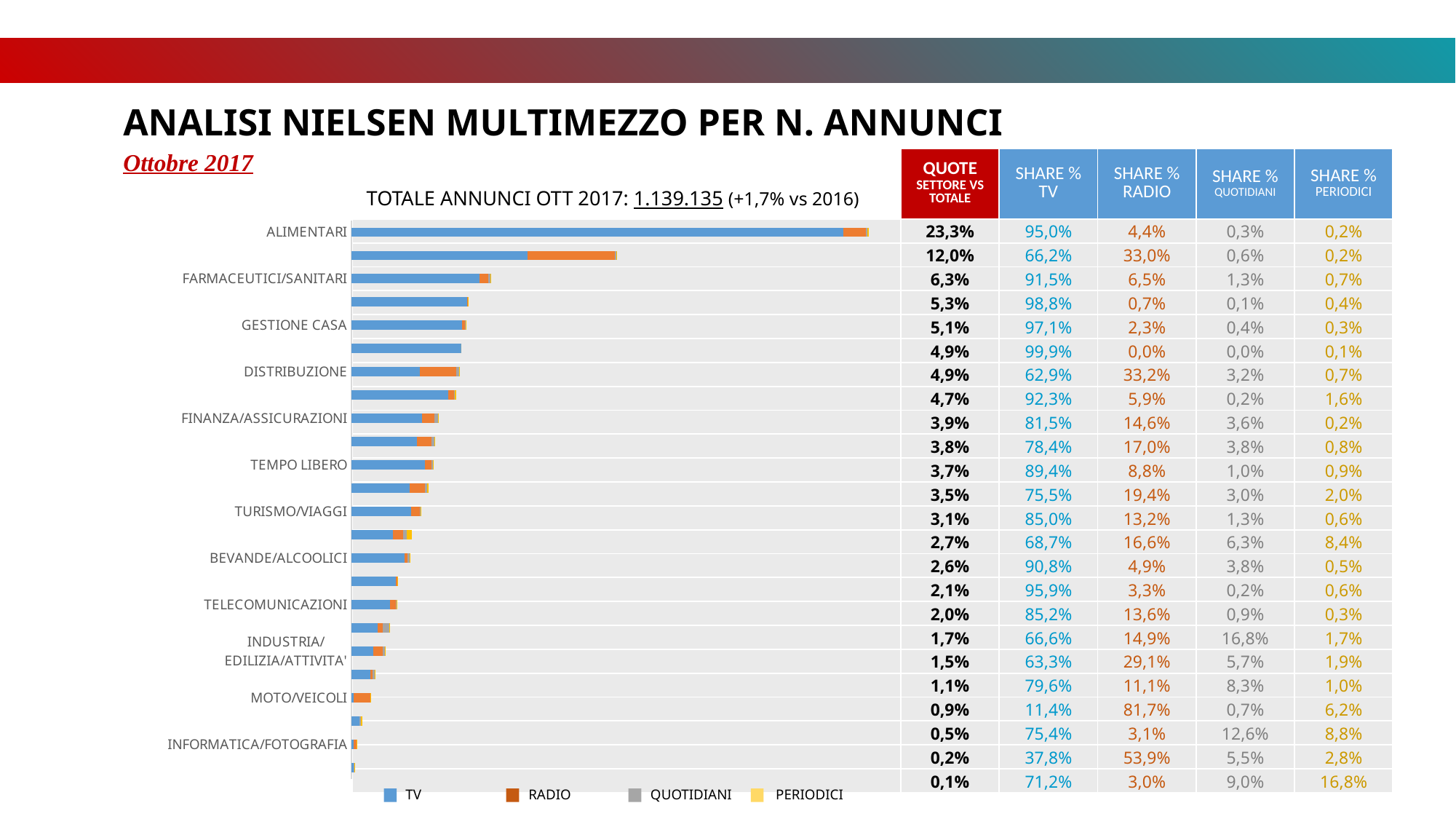
Which bar is longer, ALIMENTARI or FARMACEUTICI/SANITARI? ALIMENTARI How many bars are plotted in the chart? 24 Which series are listed in the chart legend? TV, RADIO, QUOTIDIANI, PERIODICI What is the total number of announcements stated in the chart title for October 2017? 1.139.135 What kind of chart is shown on the slide? Bar chart What is the SHARE % RADIO value for MOTO/VEICOLI? 81,7% Do the bar lengths increase or decrease going from the top of the chart to the bottom? Decrease What is the difference between the SHARE % TV values for ALIMENTARI and DISTRIBUZIONE? 32,1% Which category has the longest bar in the chart? ALIMENTARI What is the QUOTE SETTORE VS TOTALE value for ALIMENTARI? 23,3% How many series does the chart legend list? 4 What is the SHARE % TV value for GESTIONE CASA? 97,1%